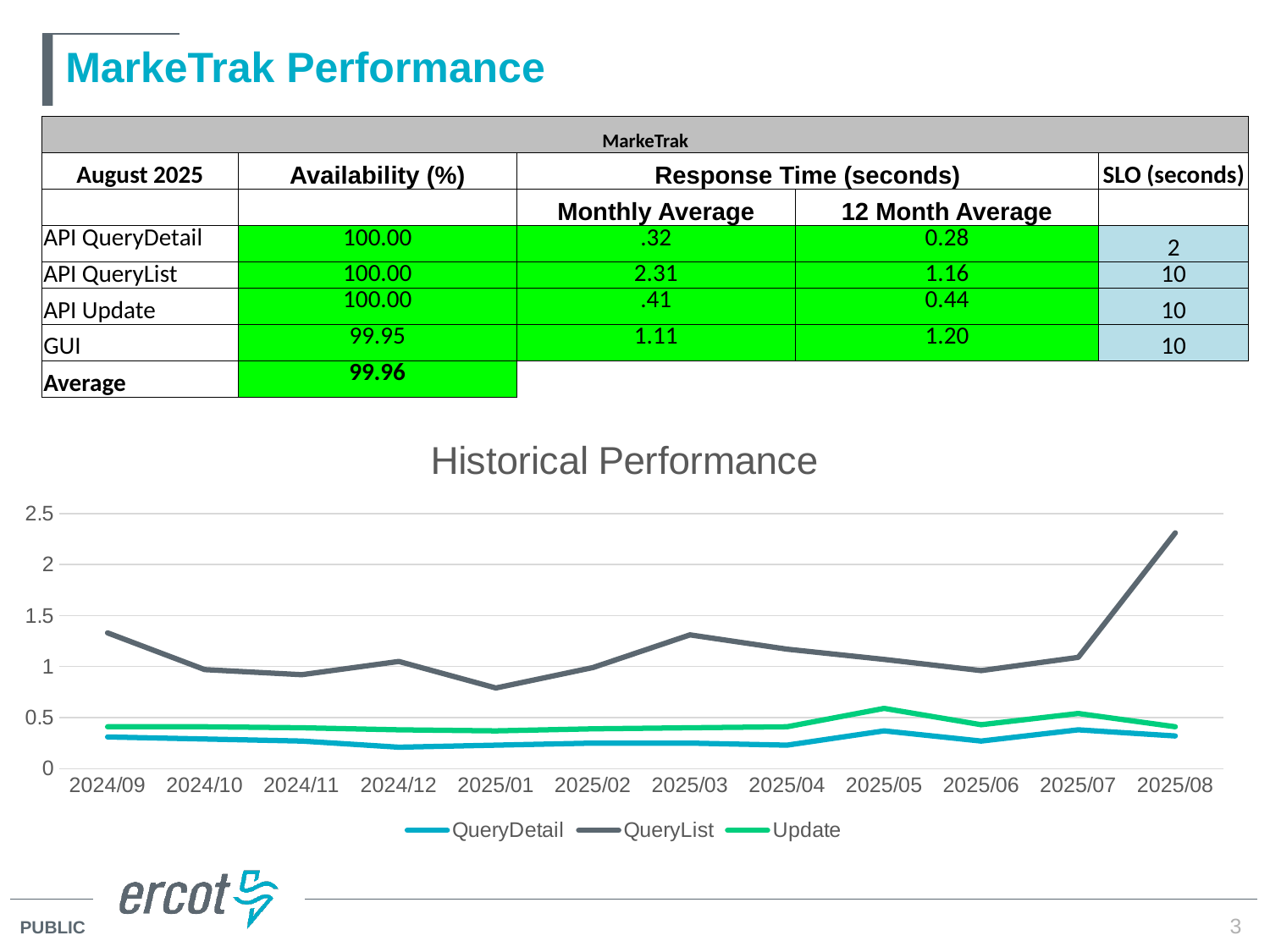
Is the QueryDetail value for 2024/12 greater or less than 0.5? less What kind of chart is shown under the title "Historical Performance"? line chart In which month does the QueryList series reach its lowest value? 2025/01 How many series does the legend of the Historical Performance chart list? 3 What are the three series names listed in the legend of the Historical Performance chart? QueryDetail, QueryList, Update Does the QueryList series rise or fall from 2025/07 to 2025/08? rise How many months are plotted along the x axis of the Historical Performance chart? 12 Which series has the highest value at 2025/08 in the Historical Performance chart? QueryList In which month does the QueryList series reach its highest value? 2025/08 Is the QueryList value for 2025/08 greater or less than 2? greater Is the QueryList value for 2025/01 greater or less than 1? less At 2025/05, which series has the larger value, Update or QueryDetail? Update